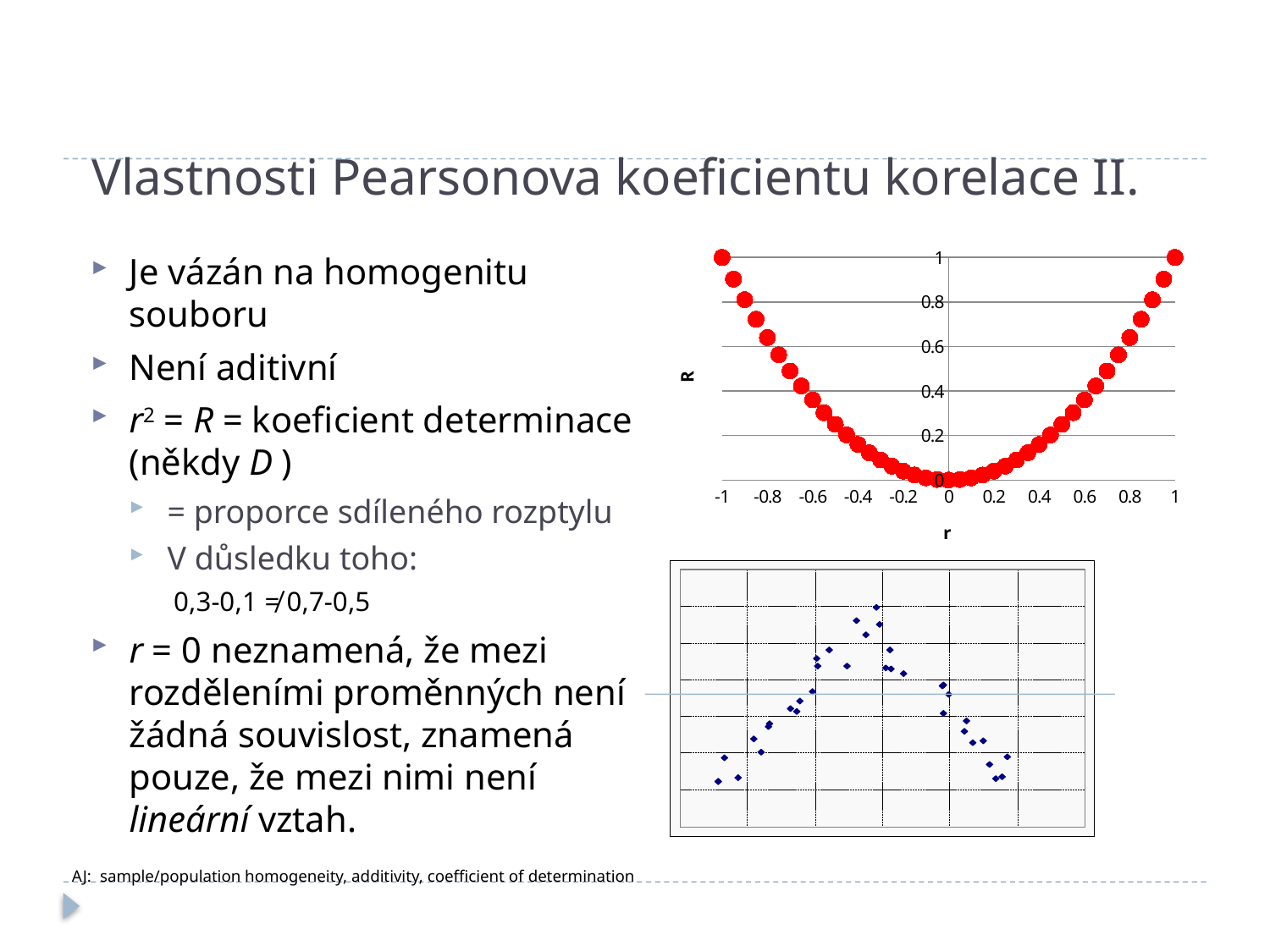
What is the label of the horizontal axis of the top-right chart? r In the top-right chart (R vs r), is the value of R at r = 0.3 greater or less than 0.2? less In the top-right chart (R vs r), do the values of R rise or fall as r goes from 0 to 1? rise In the top-right chart (R vs r), is the value of R at r = 0.7 greater or less than 0.4? greater In the top-right chart (R vs r), what is the value of R when r = 0? 0 In the top-right chart (R vs r), what is the value of R when r = -1? 1 In the top-right chart (R vs r), is the value of R at r = -0.7 greater or less than 0.6? less What kind of chart is the bottom-right chart with the blue points? scatter chart What kind of chart is the top-right chart with axes r and R? scatter chart In the top-right chart (R vs r), do the values of R rise or fall as r goes from -1 to 0? fall In the top-right chart (R vs r), at which value of r is R lowest? 0 In the top-right chart (R vs r), what is the value of R when r = 1? 1